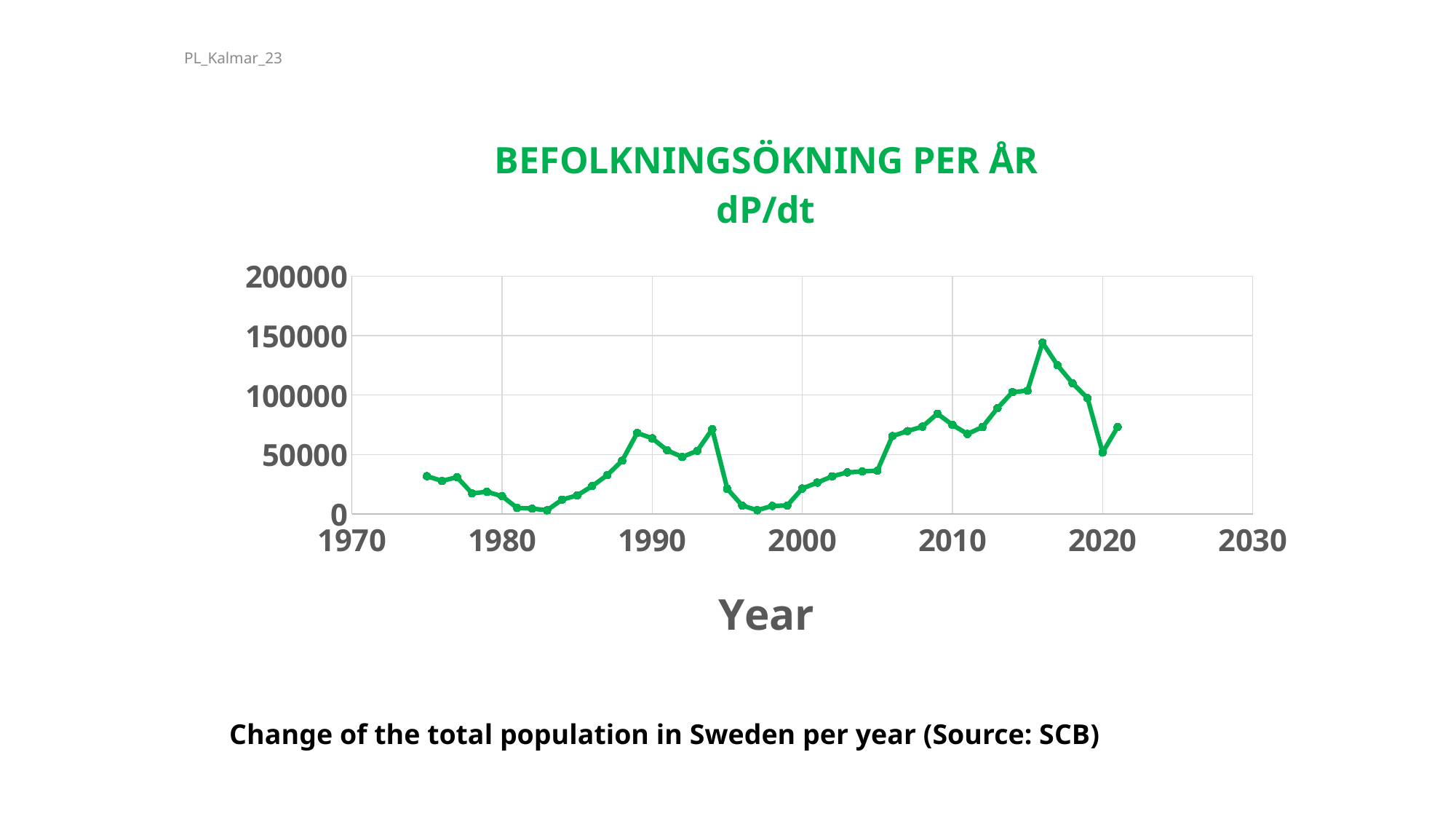
Is the value for 2016 greater or less than 100000? greater In which year does the line reach its highest value? 2016 Do the values rise or fall between 1983 and 1989? Rise What kind of chart is shown on the slide? Line chart Is the value for 1983 greater or less than 50000? less What is the label of the x axis? Year Is the value for 1989 greater or less than 100000? less What is the title of the chart? BEFOLKNINGSÖKNING PER ÅR dP/dt Which year has the larger value, 2016 or 1989? 2016 Do the values rise or fall between 2016 and 2020? Fall